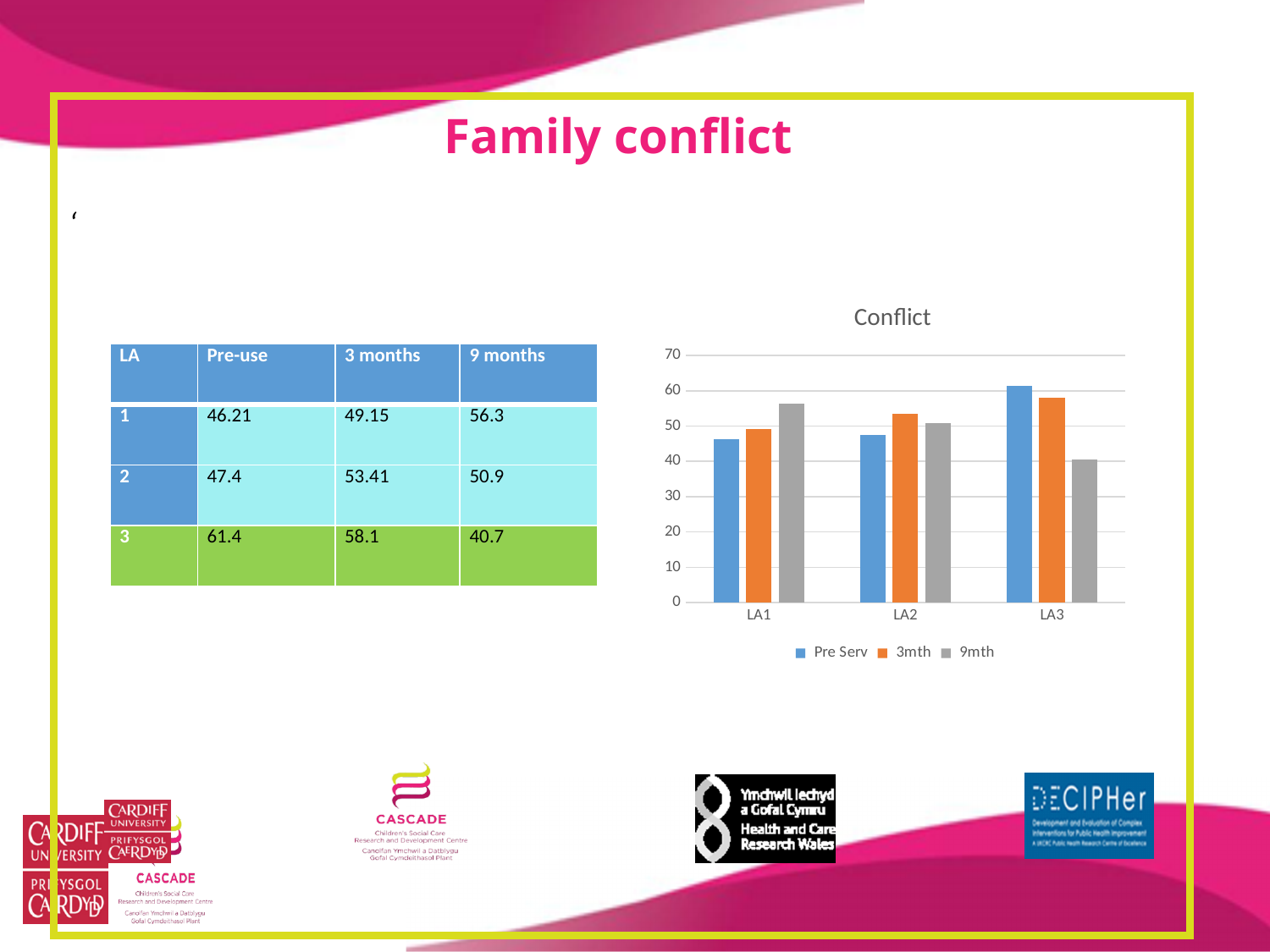
For LA1, do the values rise or fall from Pre Serv to 9mth? rise Which series has the lowest bar for LA3? 9mth Is the 9mth value for LA1 greater or less than 50? greater Is the 9mth value for LA3 greater or less than 50? less Which category has the tallest bar in the chart? LA3 How many series does the chart's legend list? 3 What is the title of the chart? Conflict How many categories are shown on the x axis of the chart? 3 For LA3, which is larger: the Pre Serv bar or the 9mth bar? Pre Serv According to the table on the slide, what is the Pre-use value for LA 1? 46.21 What are the series names listed in the chart's legend? Pre Serv, 3mth, 9mth What kind of chart is shown on the slide? bar chart